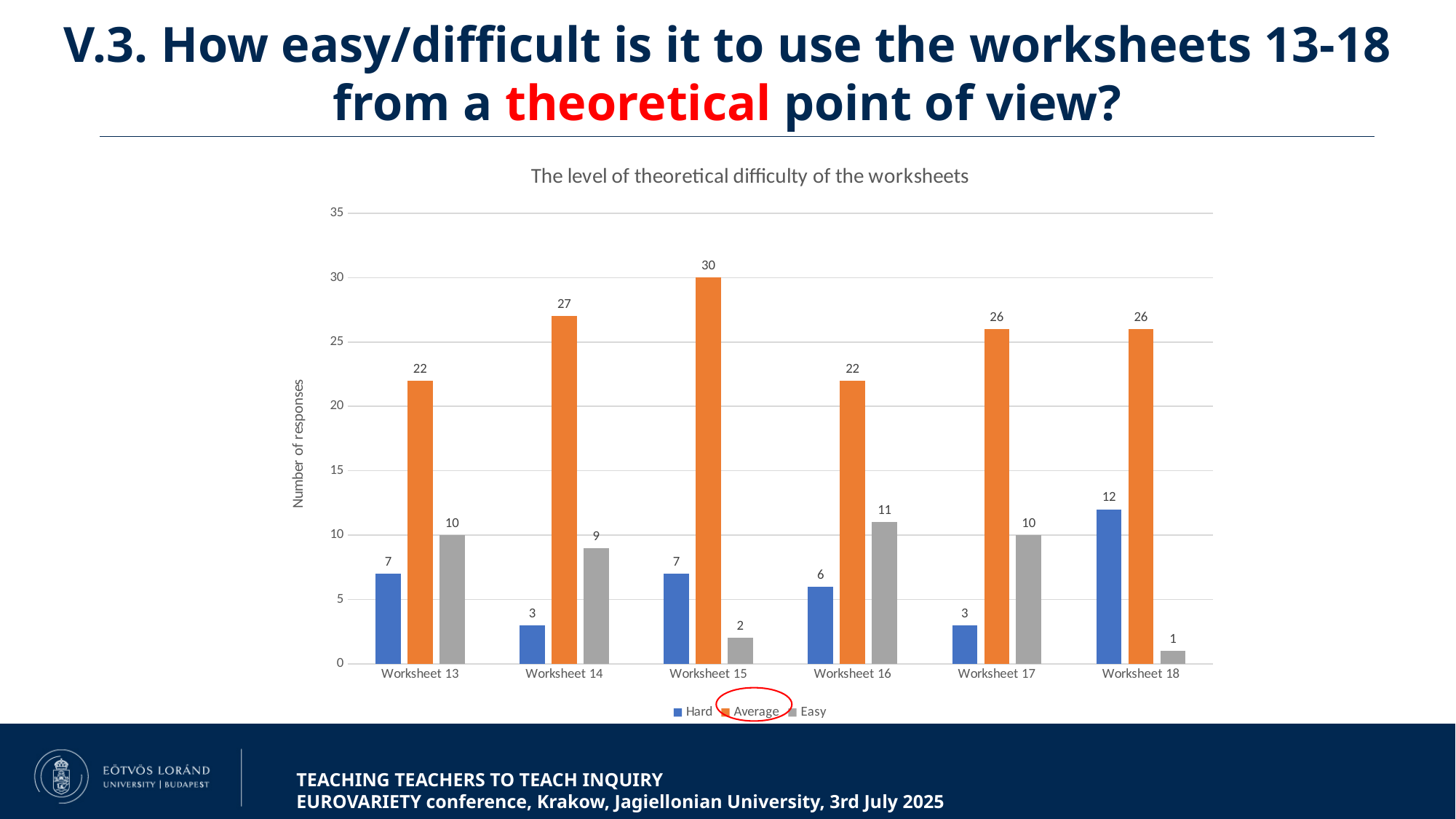
What is the 'Easy' value for Worksheet 16? 11 What is the difference between the 'Average' and 'Hard' values for Worksheet 14? 24 Is the 'Average' value for Worksheet 17 greater or less than 25? greater Which is larger: the 'Easy' value for Worksheet 13 or the 'Easy' value for Worksheet 15? Worksheet 13 What is the title of the chart? The level of theoretical difficulty of the worksheets Which worksheet has the highest 'Average' value? Worksheet 15 How many series does the legend list? 3 What kind of chart is shown on the slide? bar chart How many 'Hard' responses did Worksheet 18 receive? 12 How many worksheets are shown on the x axis? 6 Which worksheet has the lowest 'Easy' value? Worksheet 18 What is the number of 'Average' responses for Worksheet 15? 30